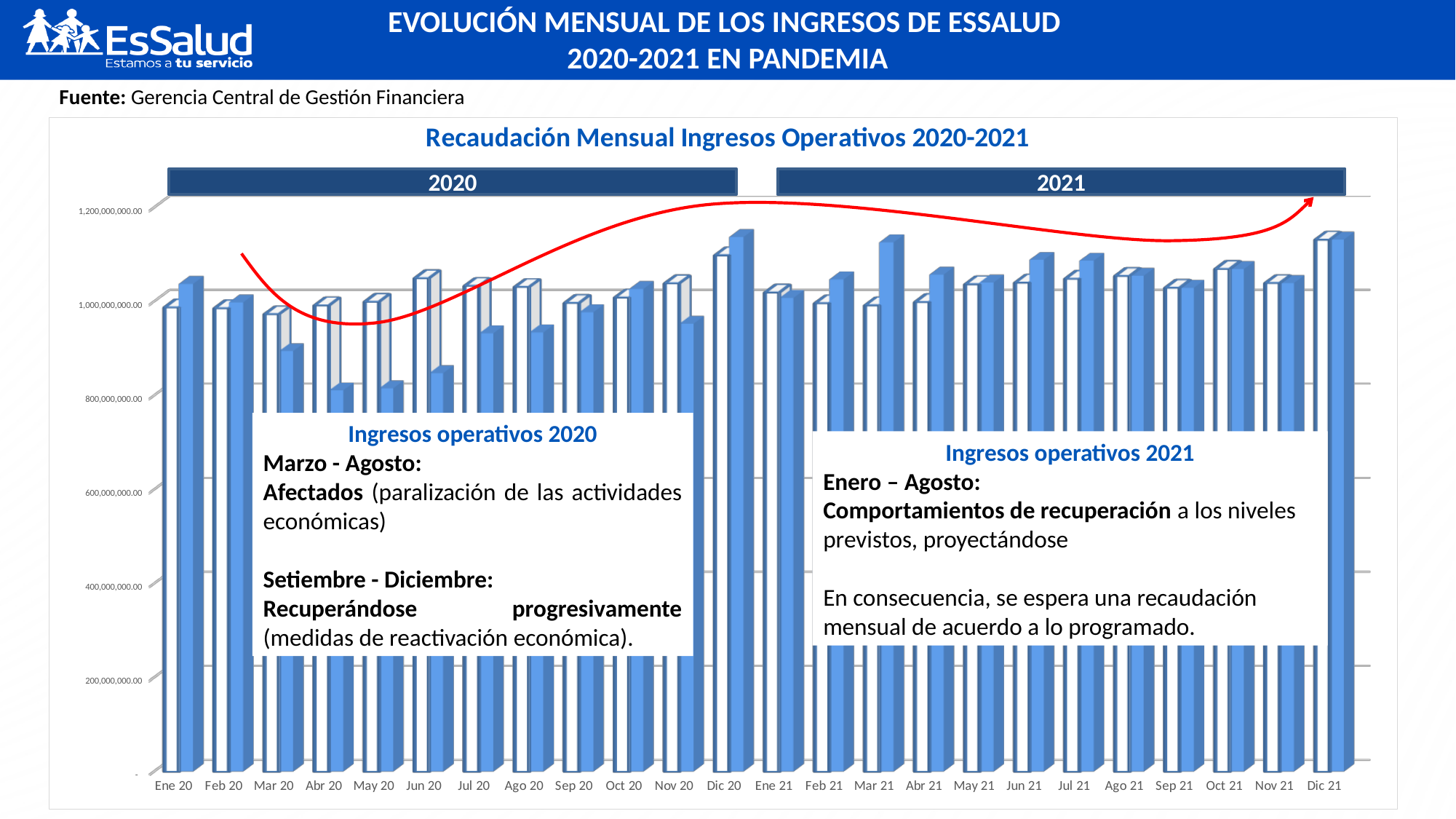
Is the value of the blue bar for Dic 20 greater or less than 1,000,000,000.00? greater Is the value of the blue bar for Abr 20 greater or less than 600,000,000.00? greater Is the value of the blue bar for Jun 20 greater or less than 1,000,000,000.00? less Which has the larger blue bar, Abr 20 or Ene 21? Ene 21 Which has the larger blue bar, Mar 20 or Dic 20? Dic 20 From Ene 20 to Mar 20, do the blue bars rise or fall? fall How many months are shown along the x axis of the chart? 24 How many bars are plotted for each month in the chart? 2 What is the title of the chart? Recaudación Mensual Ingresos Operativos 2020-2021 What kind of chart is shown on the slide? bar chart